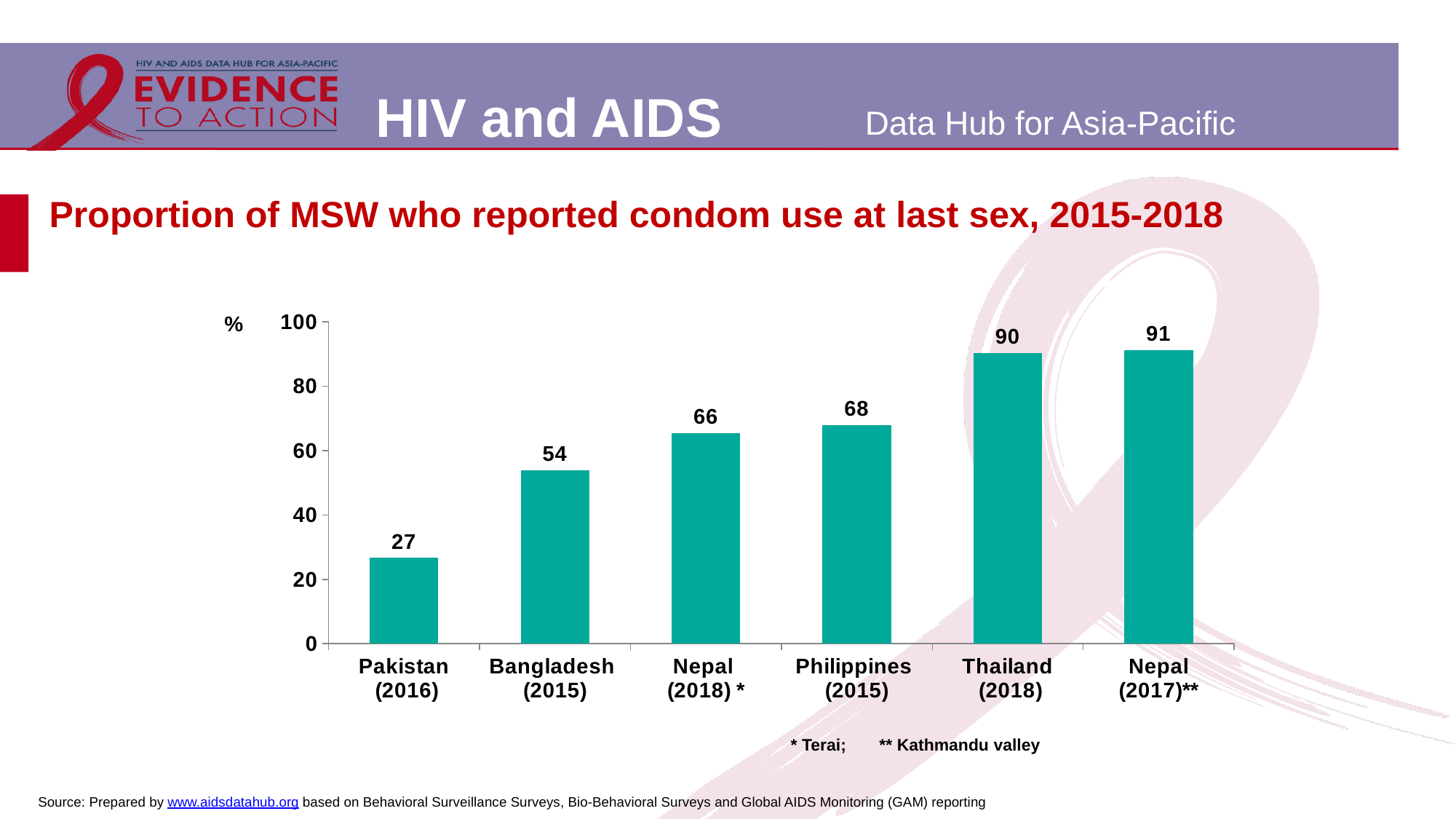
Which category has the highest value? Nepal (2017)** Which category has the lowest value? Pakistan (2016) Which is larger, the value for Philippines (2015) or the value for Bangladesh (2015)? Philippines (2015) What kind of chart is shown on the slide? bar chart Is the value for Thailand (2018) greater or less than 80? greater What is the difference between the values for Bangladesh (2015) and Pakistan (2016)? 27 How many categories are shown on the x axis? 6 What is the value for Thailand (2018)? 90 What is the value for Pakistan (2016)? 27 What is the title of the chart? Proportion of MSW who reported condom use at last sex, 2015-2018 What is the value for Nepal (2018) *? 66 Do the values rise or fall from left to right along the x axis? rise